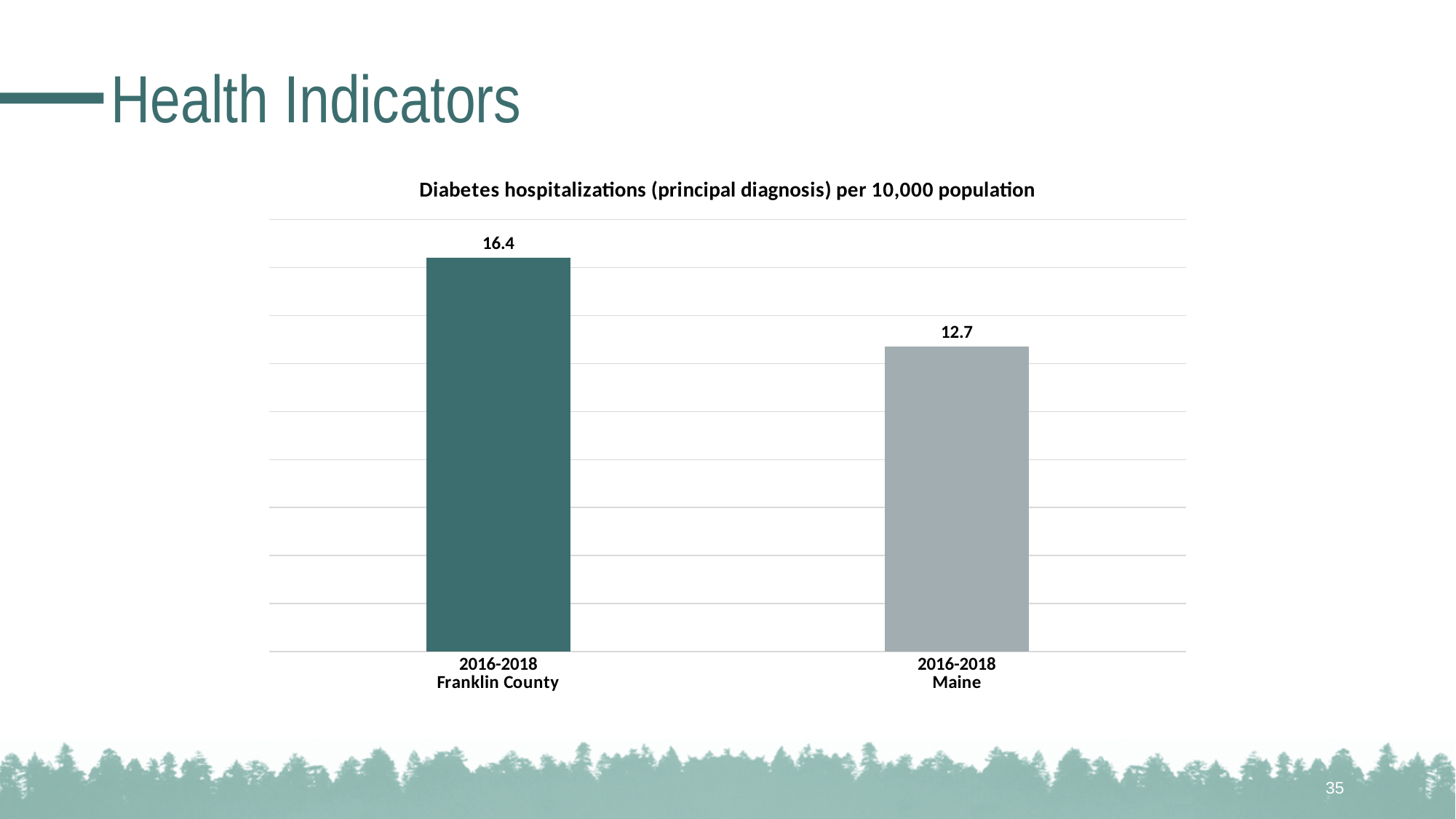
What time period do both bars in the chart cover? 2016-2018 How many bars are plotted in the chart? 2 Which category has the highest value? 2016-2018 Franklin County What kind of chart is shown on the slide? Bar chart What is the value for 2016-2018 Maine? 12.7 What is the value for 2016-2018 Franklin County? 16.4 Which is larger, the value for Franklin County or the value for Maine? Franklin County Which category has the lowest value? 2016-2018 Maine What is the difference between the Franklin County value and the Maine value? 3.7 What is the title of the chart? Diabetes hospitalizations (principal diagnosis) per 10,000 population